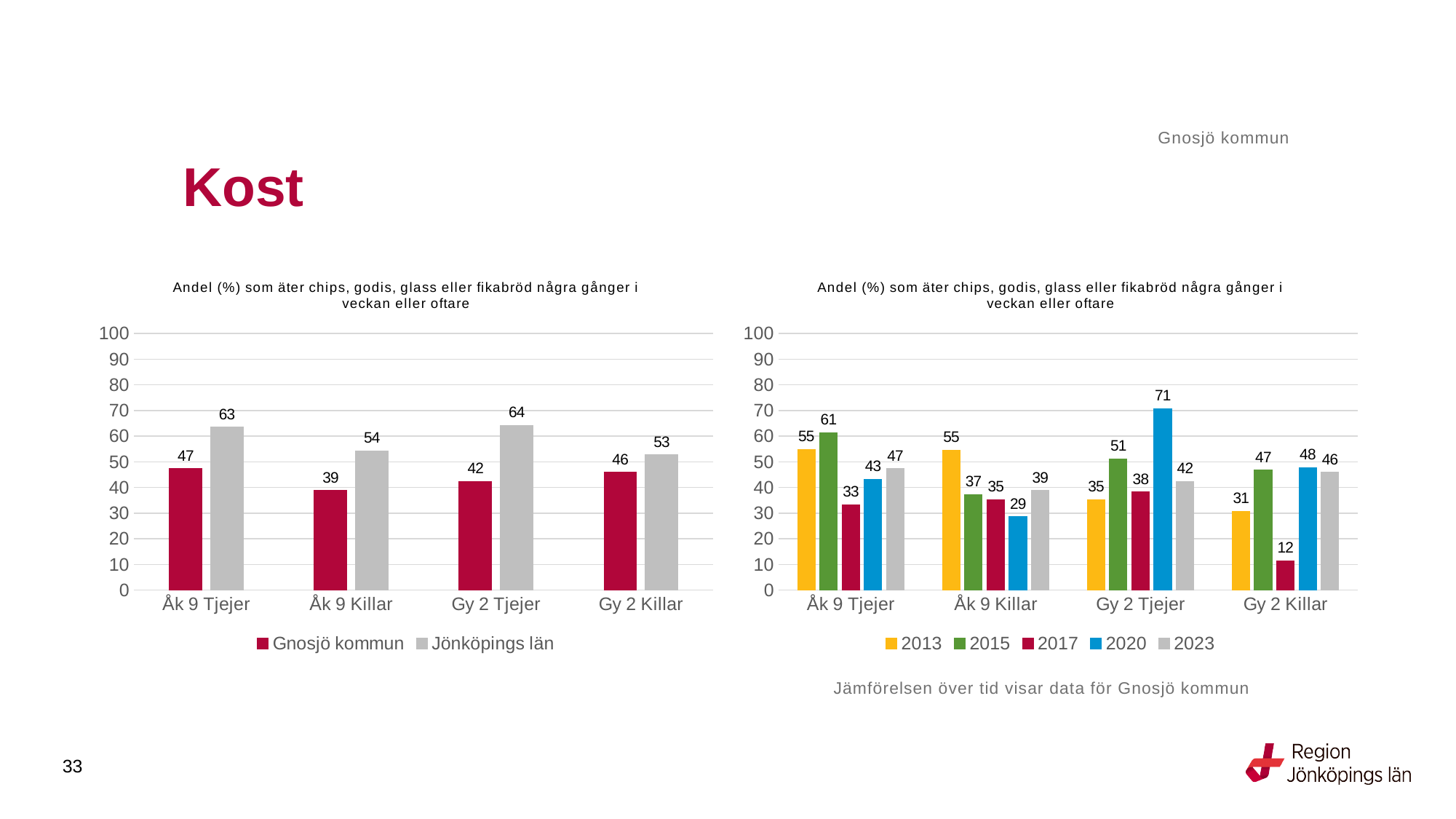
In the right chart, how many series does the legend list? 5 In the left chart, what is the value for Jönköpings län for Gy 2 Tjejer? 64 In the right chart, which is larger for Åk 9 Killar: 2013 or 2023? 2013 In the right chart, what is the value for 2020 for Gy 2 Tjejer? 71 In the left chart, what is the value for Gnosjö kommun for Åk 9 Tjejer? 47 In the right chart, what is the value for 2017 for Gy 2 Killar? 12 In the left chart, how many series does the legend list? 2 In the left chart, which category has the lowest value for Gnosjö kommun? Åk 9 Killar In the right chart, which year has the highest value for Åk 9 Tjejer? 2015 In the left chart, what is the difference between Jönköpings län and Gnosjö kommun for Åk 9 Killar? 15 What kind of chart is the left chart? Bar chart In the right chart, how many categories are shown on the x axis? 4